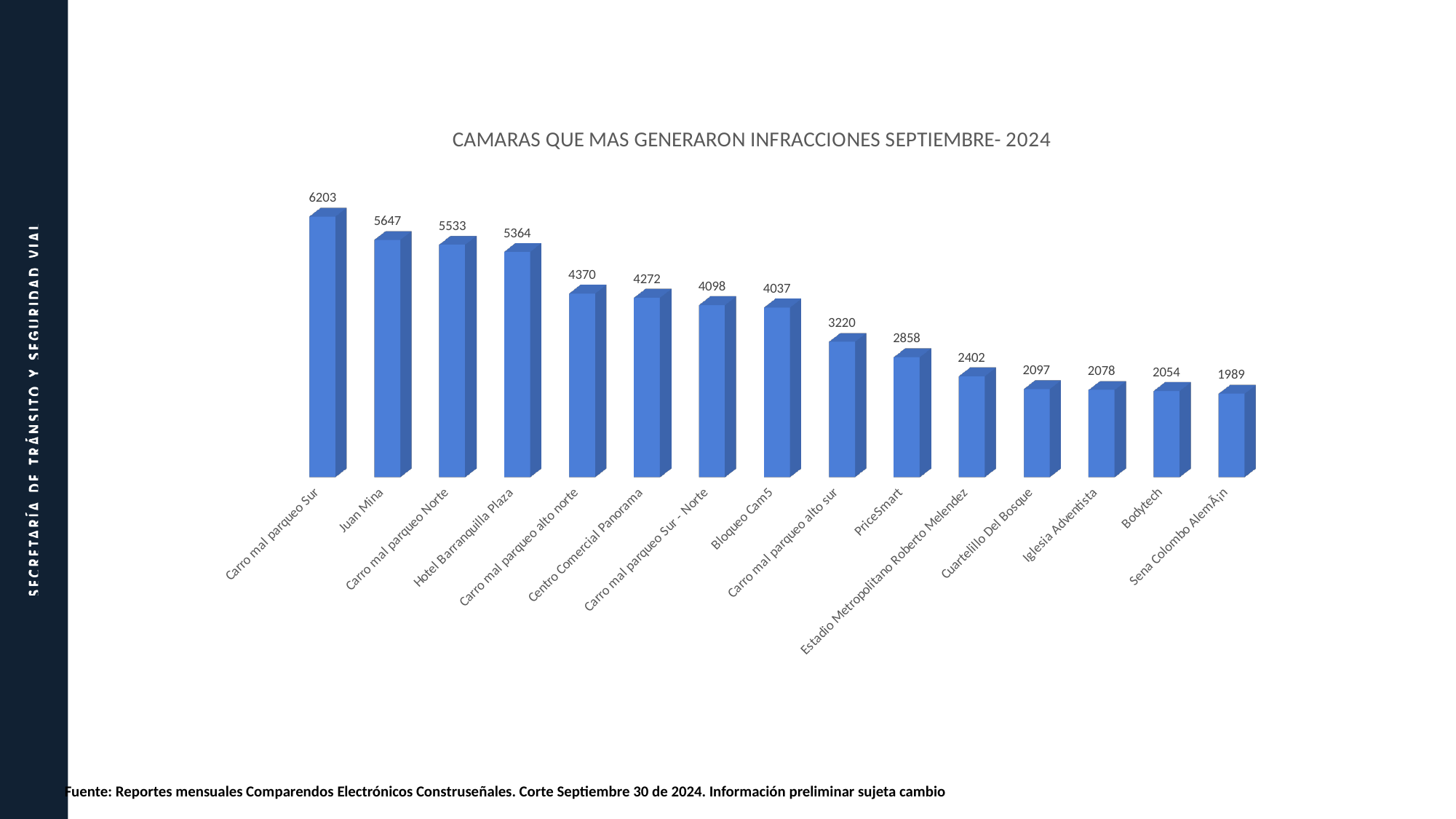
What is the value for Bodytech? 2054 Which is larger, the value for Centro Comercial Panorama or the value for Carro mal parqueo Sur - Norte? Centro Comercial Panorama What is the value for Juan Mina? 5647 Which category has the lowest value? Sena Colombo AlemÃ¡n Which category has the highest value? Carro mal parqueo Sur What is the difference between the values for Carro mal parqueo Sur and Juan Mina? 556 What is the value for Hotel Barranquilla Plaza? 5364 What kind of chart is shown on the slide? Bar chart What is the difference between the values for Bloqueo Cam5 and Carro mal parqueo alto sur? 817 How many categories are shown in the chart? 15 What is the value for PriceSmart? 2858 Do the values rise or fall from left to right along the x axis? Fall